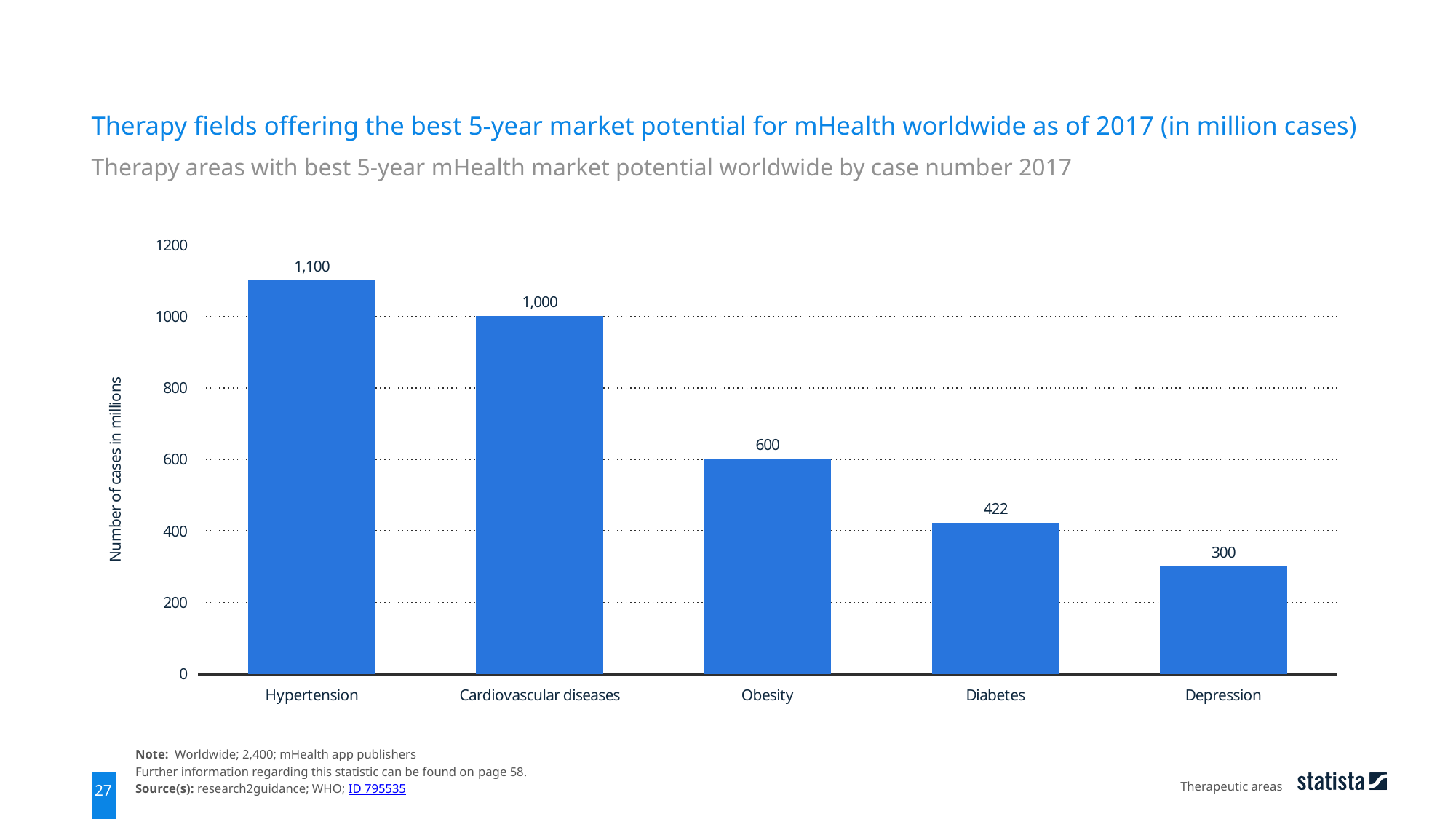
What kind of chart is shown on the slide? Bar chart Which therapy field has the lowest number of cases? Depression What is the difference between the values for Hypertension and Cardiovascular diseases? 100 What is the value shown for Depression? 300 What is the number of cases in millions for Hypertension? 1,100 How many therapy fields are shown in the chart? 5 What is the difference between the values for Obesity and Diabetes? 178 Which therapy field has the highest number of cases? Hypertension What is the label of the vertical axis? Number of cases in millions Which has a larger value, Obesity or Depression? Obesity Is the value for Diabetes greater or less than 400? greater What is the value shown for Diabetes? 422